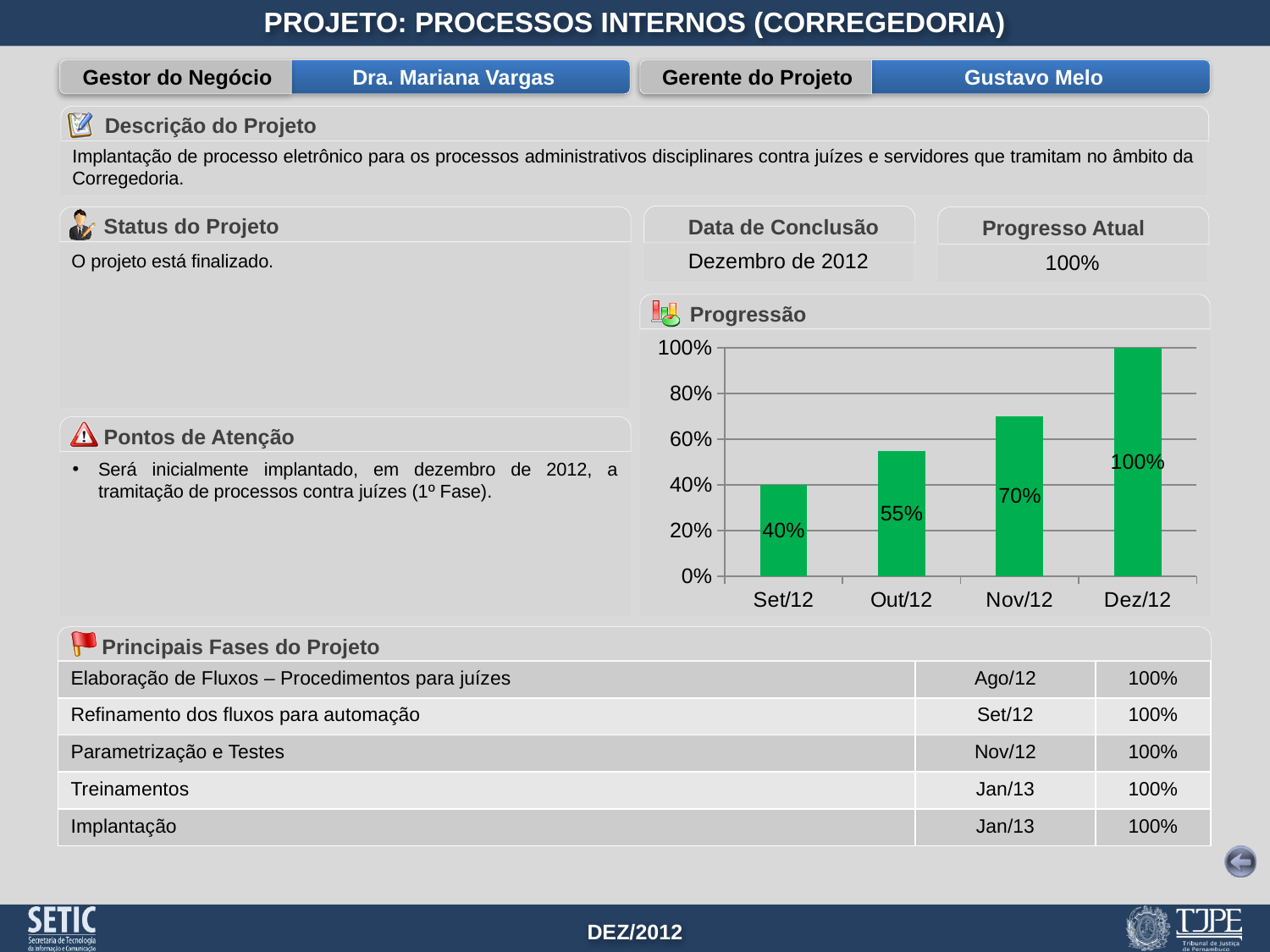
Do the values in the Progressão chart rise or fall from Set/12 to Dez/12? Rise Which month has the highest value in the Progressão chart? Dez/12 What is the value for Out/12 in the Progressão chart? 55% What is the value for Nov/12 in the Progressão chart? 70% What is the difference between the values for Dez/12 and Nov/12 in the Progressão chart? 30% What is the difference between the values for Out/12 and Set/12 in the Progressão chart? 15% Which is larger in the Progressão chart, the value for Nov/12 or Out/12? Nov/12 What is the value for Set/12 in the Progressão chart? 40% How many months are shown on the x axis of the Progressão chart? 4 What kind of chart is the Progressão chart? Bar chart What is the value for Dez/12 in the Progressão chart? 100% Which month has the lowest value in the Progressão chart? Set/12